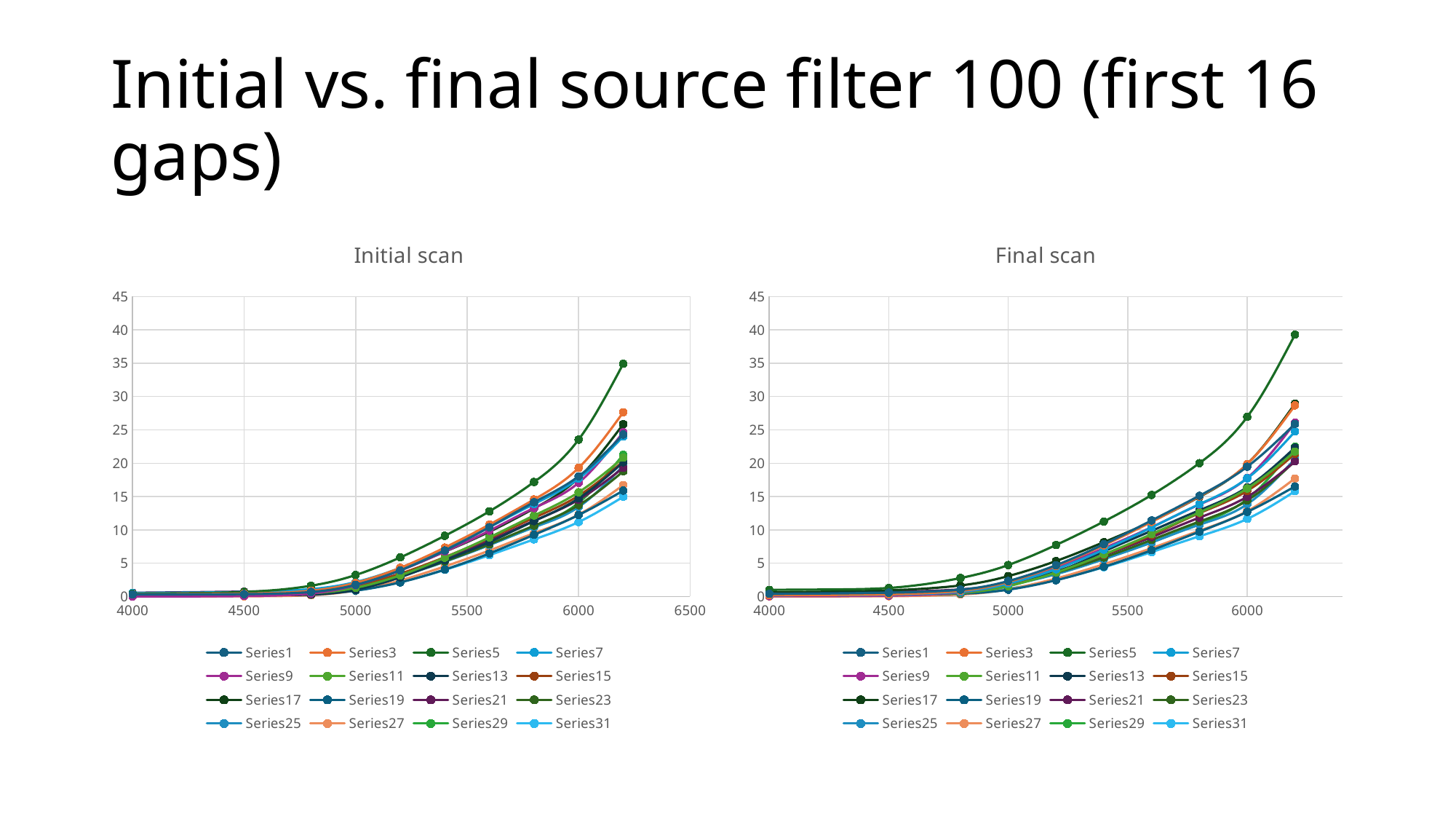
What is the title of the chart on the left of the slide? Initial scan What kind of chart is the "Initial scan" chart? line chart What kind of chart is the "Final scan" chart? line chart How many series does the legend of the "Final scan" chart list? 16 How many series does the legend of the "Initial scan" chart list? 16 In the "Final scan" chart, do the values rise or fall as the x axis increases from 4000 to 6200? rise In the "Final scan" chart, is the highest value at x = 6200 greater or less than 35? greater In the "Initial scan" chart, do the values rise or fall as the x axis increases from 4000 to 6200? rise In the "Initial scan" chart, is the highest value at x = 6200 greater or less than 30? greater In the "Final scan" chart, are all series values at x = 4000 greater or less than 5? less What is the title of the chart on the right of the slide? Final scan